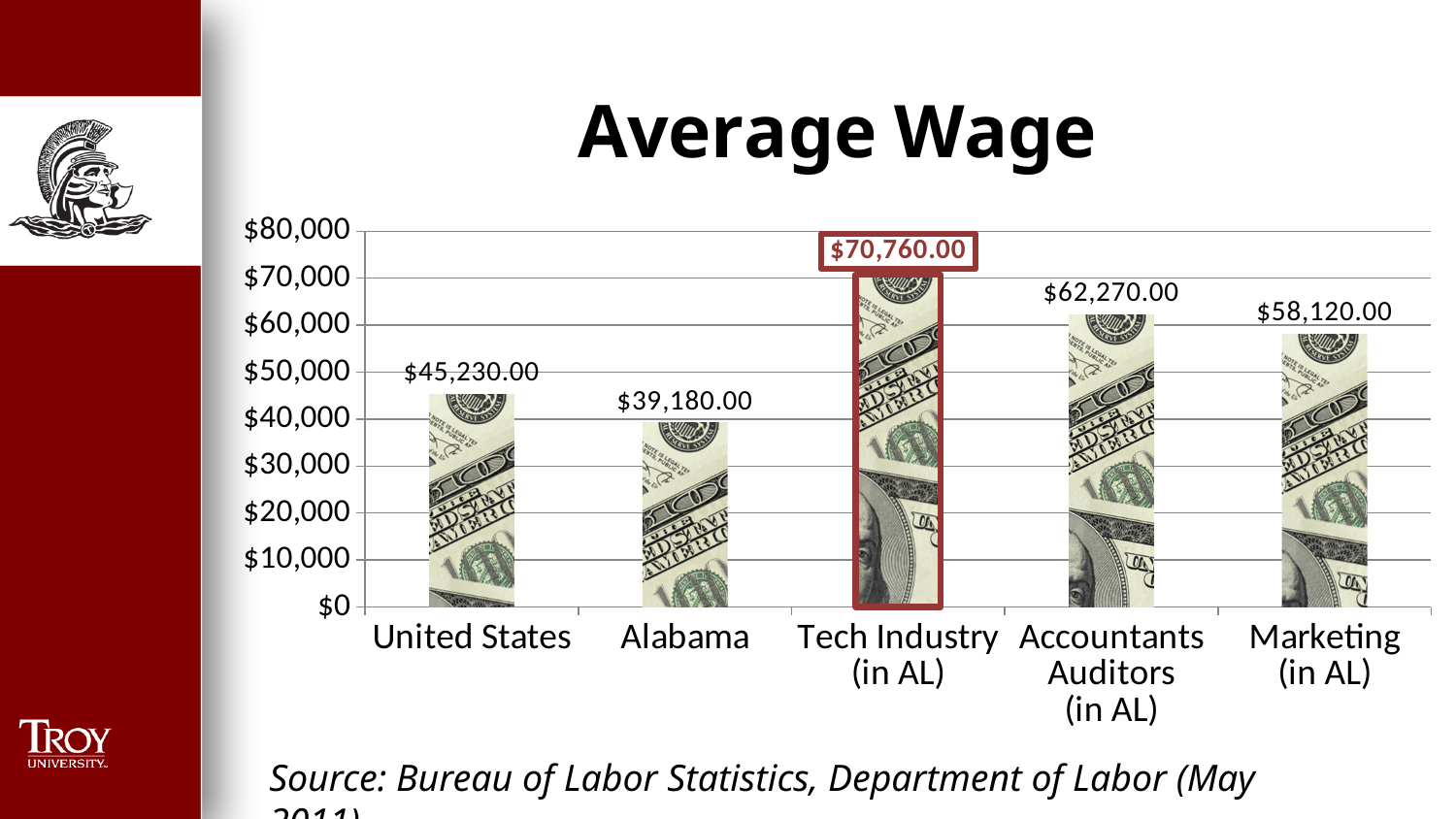
What is the difference between the average wage for Tech Industry (in AL) and Accountants Auditors (in AL)? $8,490.00 Which has a higher average wage, Accountants Auditors (in AL) or Marketing (in AL)? Accountants Auditors (in AL) What is the average wage shown for Alabama? $39,180.00 What kind of chart is shown on the slide? Bar chart What is the title of the chart? Average Wage What is the difference between the average wage for the United States and Alabama? $6,050.00 What is the average wage shown for Tech Industry (in AL)? $70,760.00 Which category has the lowest average wage? Alabama Which category has the highest average wage? Tech Industry (in AL) What is the average wage shown for Marketing (in AL)? $58,120.00 What is the average wage shown for the United States? $45,230.00 How many categories are shown in the chart? 5